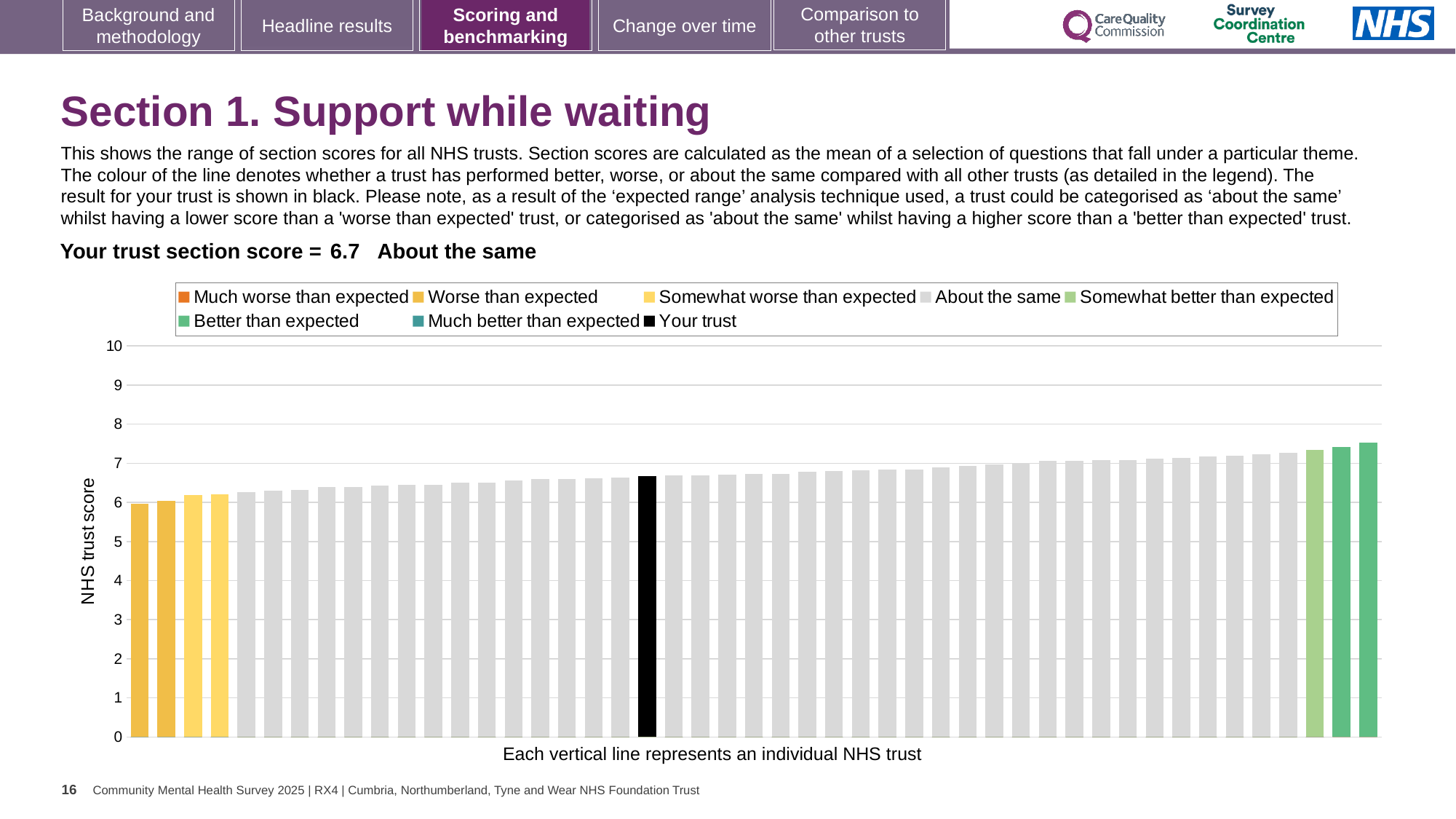
What kind of chart is shown on the slide? bar chart What is the section score for your trust shown on the slide? 6.7 What is the label on the vertical axis of the chart? NHS trust score Is the value of the shortest bar in the chart greater or less than 5? greater How many entries does the chart legend list? 8 Is the value of the tallest bar in the chart greater or less than 7? greater Is the value of the black 'Your trust' bar greater or less than 7? less How many bars are coloured in the 'Better than expected' green shade? 2 Which performance category is your trust placed in according to the slide? About the same Do the bar values rise or fall from left to right across the chart? rise Which legend category do the tallest bars in the chart belong to? Better than expected